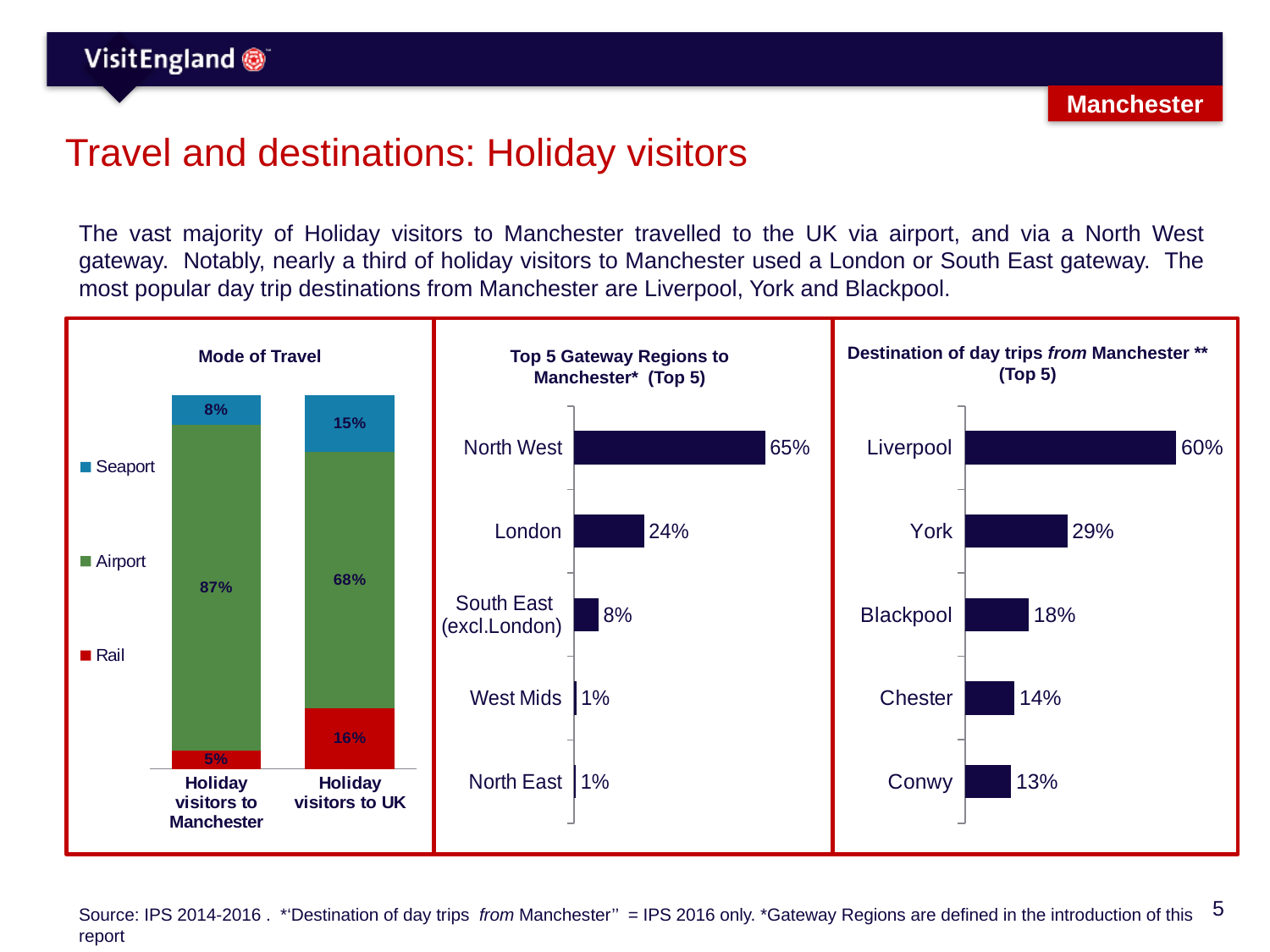
In the 'Top 5 Gateway Regions to Manchester' chart, what is the value for London? 24% What kind of chart is the 'Destination of day trips from Manchester' chart? Bar chart In the 'Destination of day trips from Manchester' chart, which destination has the lowest value? Conwy In the 'Destination of day trips from Manchester' chart, which is larger, York or Chester? York In the 'Mode of Travel' chart, what percentage of Holiday visitors to Manchester travelled by Airport? 87% In the 'Mode of Travel' chart, what is the difference between the Seaport share for Holiday visitors to UK and for Holiday visitors to Manchester? 7% In the 'Destination of day trips from Manchester' chart, what is the value for Blackpool? 18% In the 'Mode of Travel' chart, what percentage of Holiday visitors to UK travelled by Rail? 16% In the 'Mode of Travel' chart, what is the total of the stacked bar for Holiday visitors to Manchester? 100% In the 'Top 5 Gateway Regions to Manchester' chart, what is the difference between North West and London? 41% In the 'Top 5 Gateway Regions to Manchester' chart, which region has the highest value? North West In the 'Mode of Travel' chart, how many series does the legend list? 3